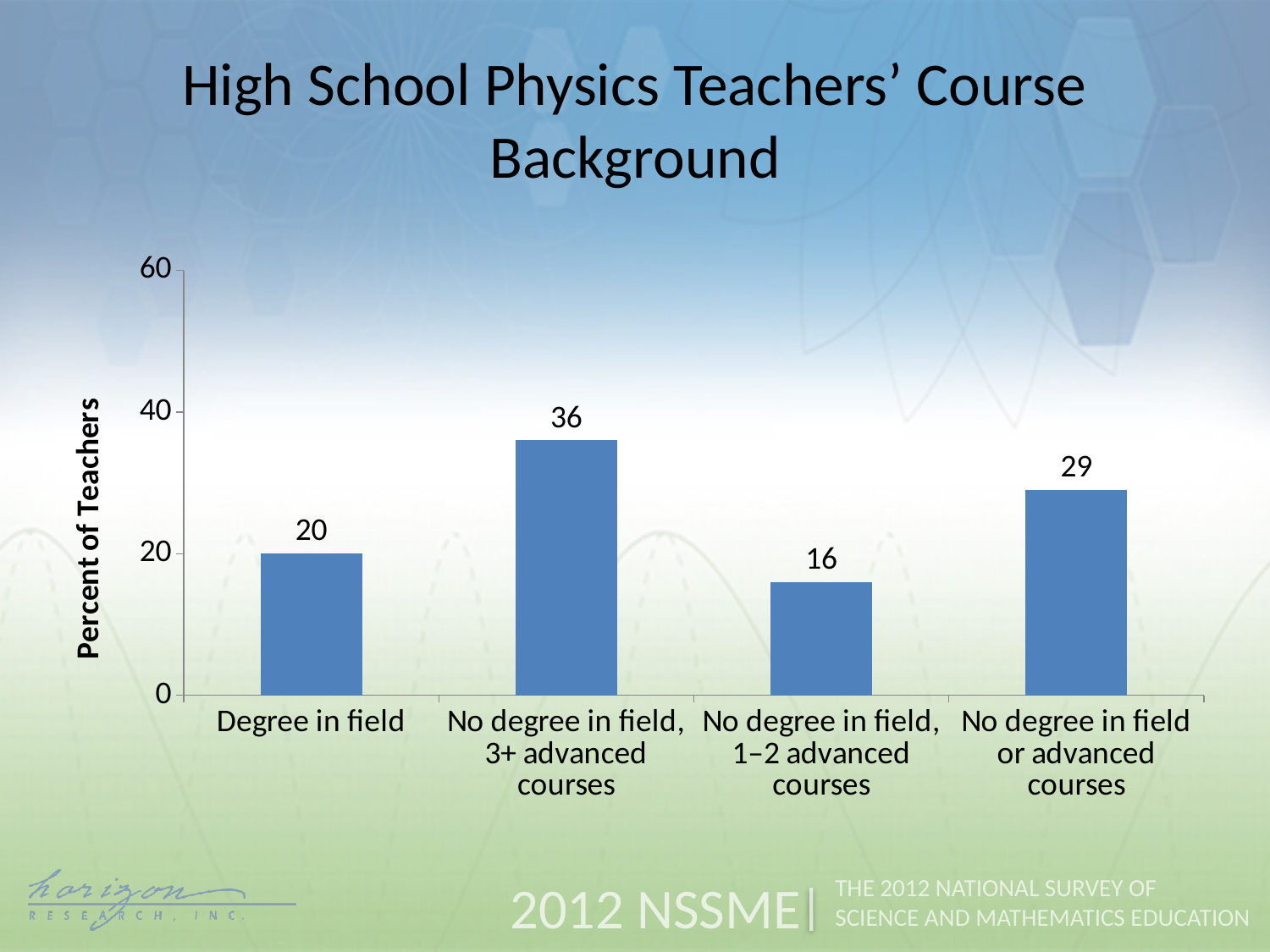
Which category has the lowest percent of teachers? No degree in field, 1–2 advanced courses What is the label of the y axis? Percent of Teachers How many categories are shown on the x axis? 4 Is the value for 'No degree in field, 3+ advanced courses' greater or less than 40? less What is the value for 'No degree in field or advanced courses'? 29 What is the value for 'No degree in field, 1–2 advanced courses'? 16 What is the difference between the values for 'No degree in field, 3+ advanced courses' and 'Degree in field'? 16 Which is larger: the value for 'Degree in field' or for 'No degree in field or advanced courses'? No degree in field or advanced courses What percent of high school physics teachers have a degree in field? 20 What kind of chart is shown on the slide? Bar chart What is the value for 'No degree in field, 3+ advanced courses'? 36 Which category has the highest percent of teachers? No degree in field, 3+ advanced courses